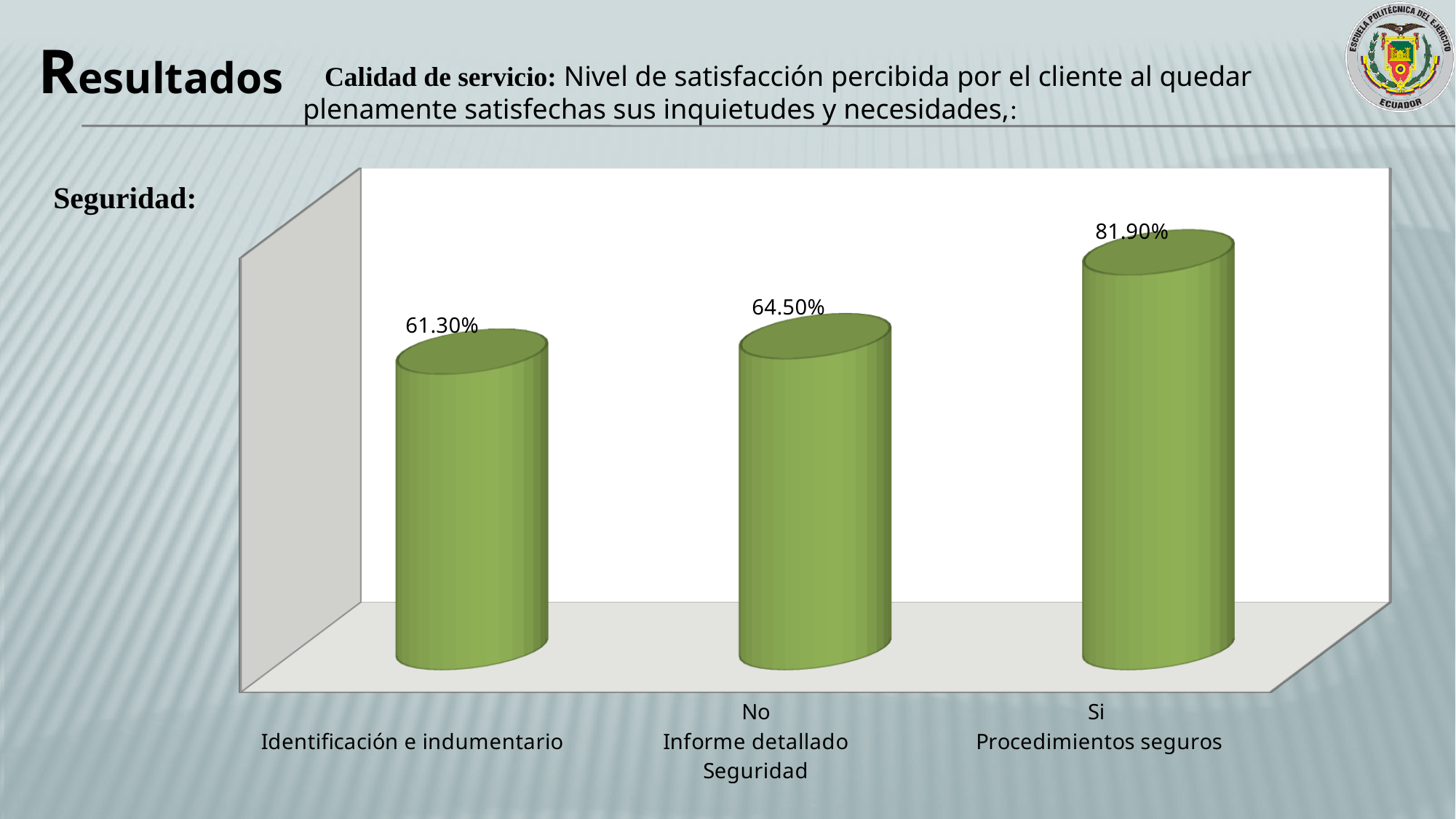
What kind of chart is shown on the slide? Bar chart Which category has the lowest value? Identificación e indumentario What is the difference between the values for Procedimientos seguros and Identificación e indumentario? 20.60% What is the difference between the values for Informe detallado and Identificación e indumentario? 3.20% Do the values rise or fall from left to right across the categories? Rise Which is larger, the value for Informe detallado or the value for Procedimientos seguros? Procedimientos seguros What is the value shown for Procedimientos seguros? 81.90% How many categories are plotted in the chart? 3 What is the value shown for Identificación e indumentario? 61.30% What is the label shown beneath the category axis of the chart? Seguridad Which category has the highest value? Procedimientos seguros What is the value shown for Informe detallado? 64.50%